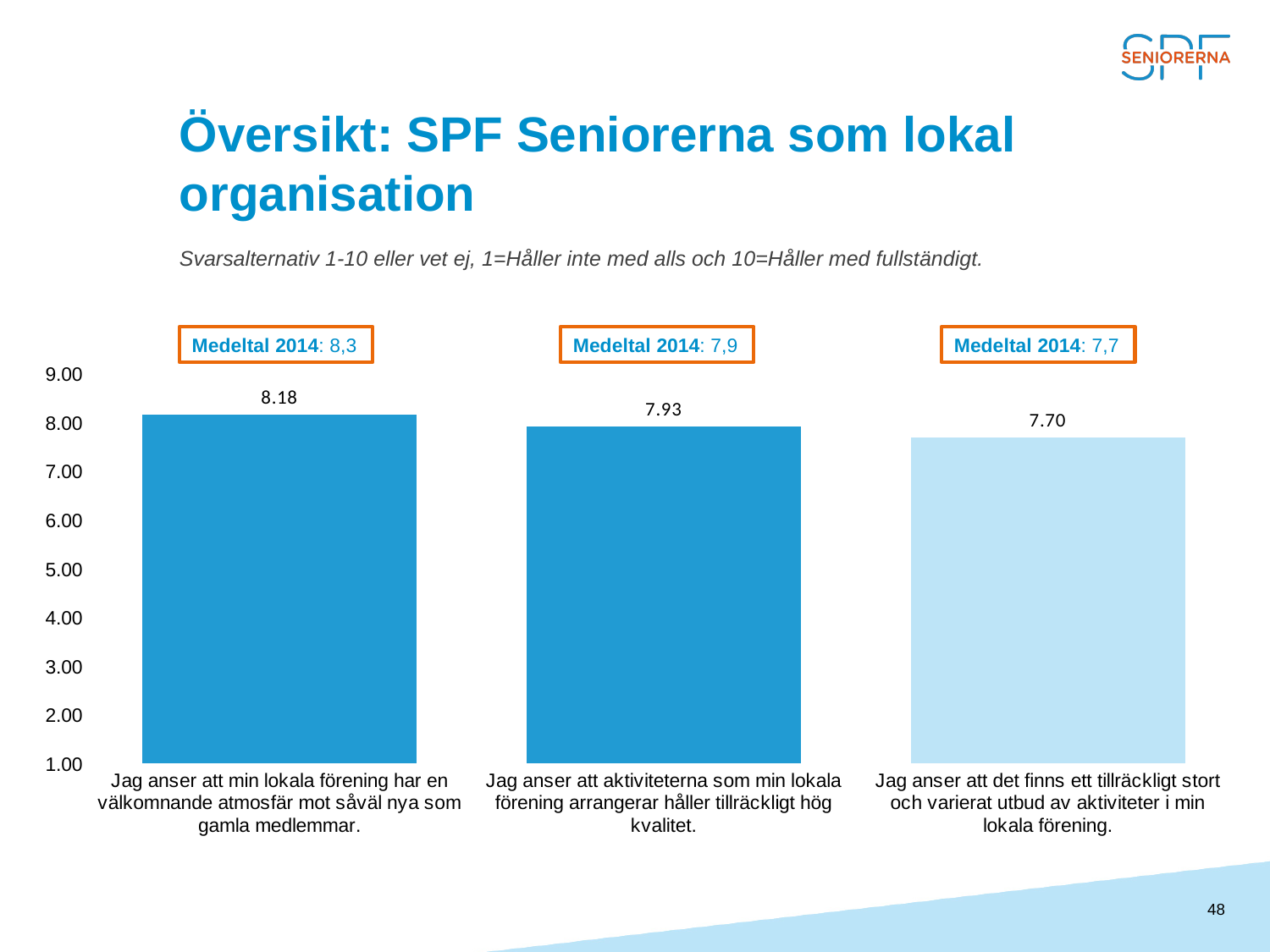
What kind of chart is shown on the slide? Bar chart What is the "Medeltal 2014" value shown above the bar for the statement about activity quality (tillräckligt hög kvalitet)? 7,9 What is the value of the bar for "Jag anser att min lokala förening har en välkomnande atmosfär mot såväl nya som gamla medlemmar."? 8.18 What is the difference between the bar values 8.18 and 7.93? 0.25 Which is larger: the bar for the statement about welcoming atmosphere (välkomnande atmosfär) or the bar for the statement about activity quality (tillräckligt hög kvalitet)? The welcoming atmosphere statement (8.18) What is the value of the bar for "Jag anser att det finns ett tillräckligt stort och varierat utbud av aktiviteter i min lokala förening."? 7.70 What is the difference between the highest bar value (8.18) and the lowest bar value (7.70)? 0.48 Which statement has the lowest bar value? Jag anser att det finns ett tillräckligt stort och varierat utbud av aktiviteter i min lokala förening. What is the value of the bar for "Jag anser att aktiviteterna som min lokala förening arrangerar håller tillräckligt hög kvalitet."? 7.93 Which statement has the highest bar value? Jag anser att min lokala förening har en välkomnande atmosfär mot såväl nya som gamla medlemmar. Do the bar values rise or fall from left to right across the chart? Fall How many bars are shown in the chart? 3